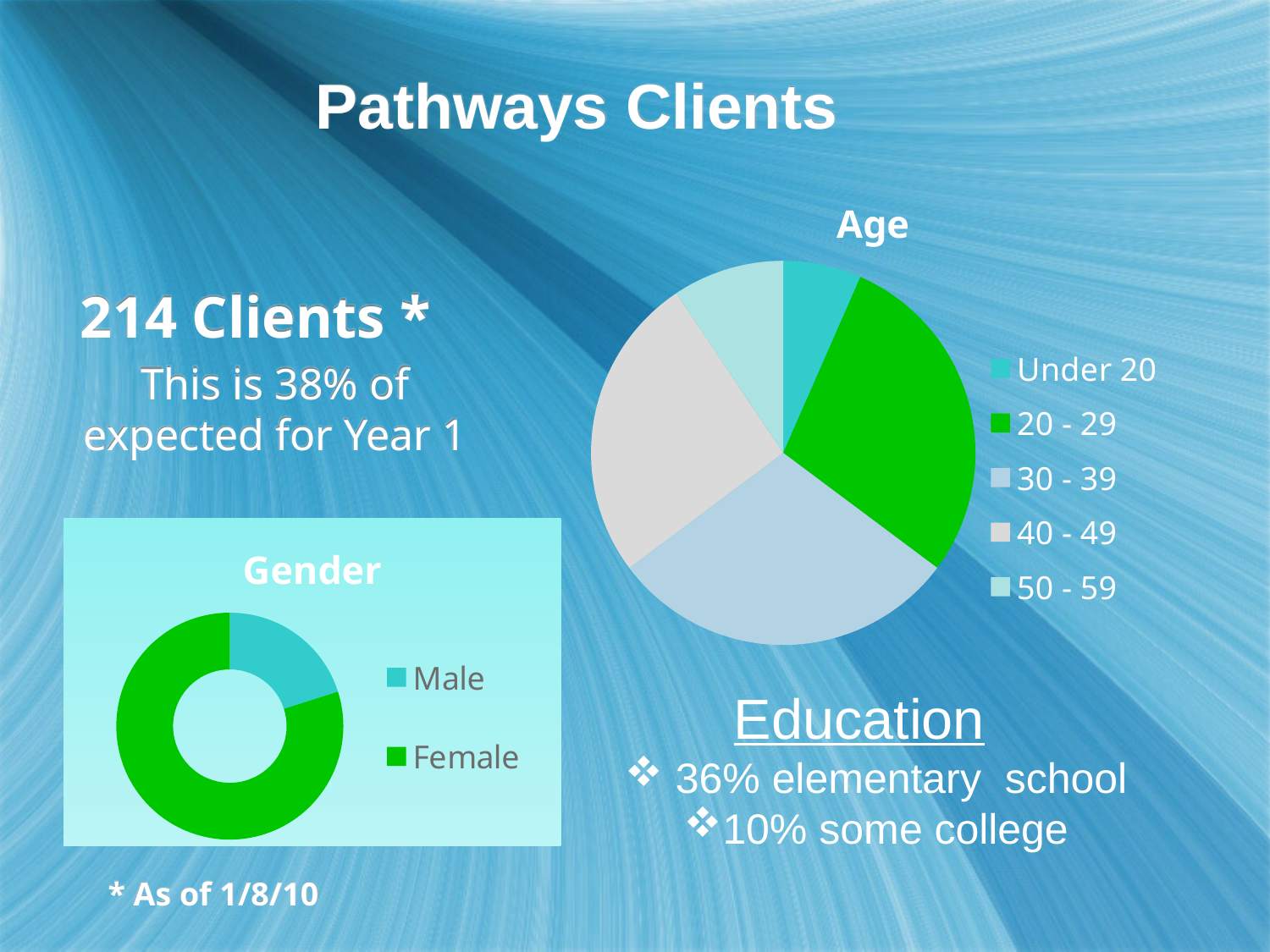
In the Age chart, what is the last age group listed in the legend? 50 - 59 What kind of chart is the Age chart? pie chart In the Age chart, which slice is larger, 30 - 39 or 50 - 59? 30 - 39 In the Age chart, which age group has the smallest slice? Under 20 In the Age chart, which slice is larger, Under 20 or 20 - 29? 20 - 29 How many age groups does the Age chart show? 5 In the Gender chart, what colour represents Female? green In the Age chart, which slice is larger, 40 - 49 or 50 - 59? 40 - 49 What kind of chart is the Gender chart? doughnut chart In the Gender chart, which category has the smaller share? Male In the Gender chart, which category has the larger share? Female How many categories does the Gender chart show? 2